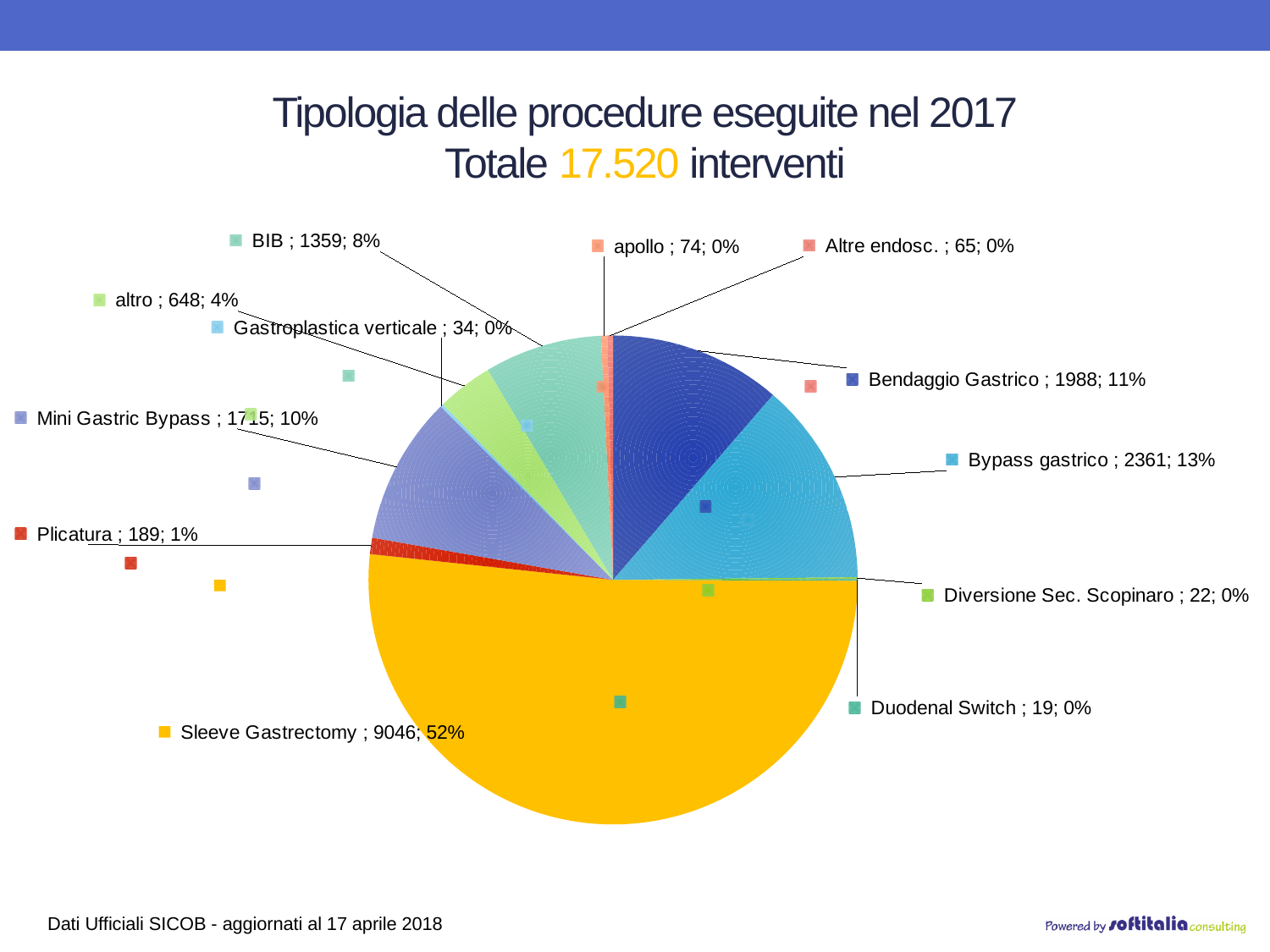
What is the title of the chart? Tipologia delle procedure eseguite nel 2017 Totale 17.520 interventi What is the difference between the number of interventions for Bypass gastrico and Bendaggio Gastrico? 373 Which procedure has the smallest slice of the pie? Duodenal Switch What is the total number of interventions stated in the chart title? 17.520 How many slices (categories) does the pie chart have? 12 What share of the pie does Sleeve Gastrectomy represent? 52% Which procedure has the largest slice of the pie? Sleeve Gastrectomy How many interventions are shown for Bendaggio Gastrico? 1988 How many interventions are shown for Bypass gastrico? 2361 What share of the pie does Mini Gastric Bypass represent? 10% What kind of chart is shown on the slide? pie chart Which has more interventions, BIB or altro? BIB